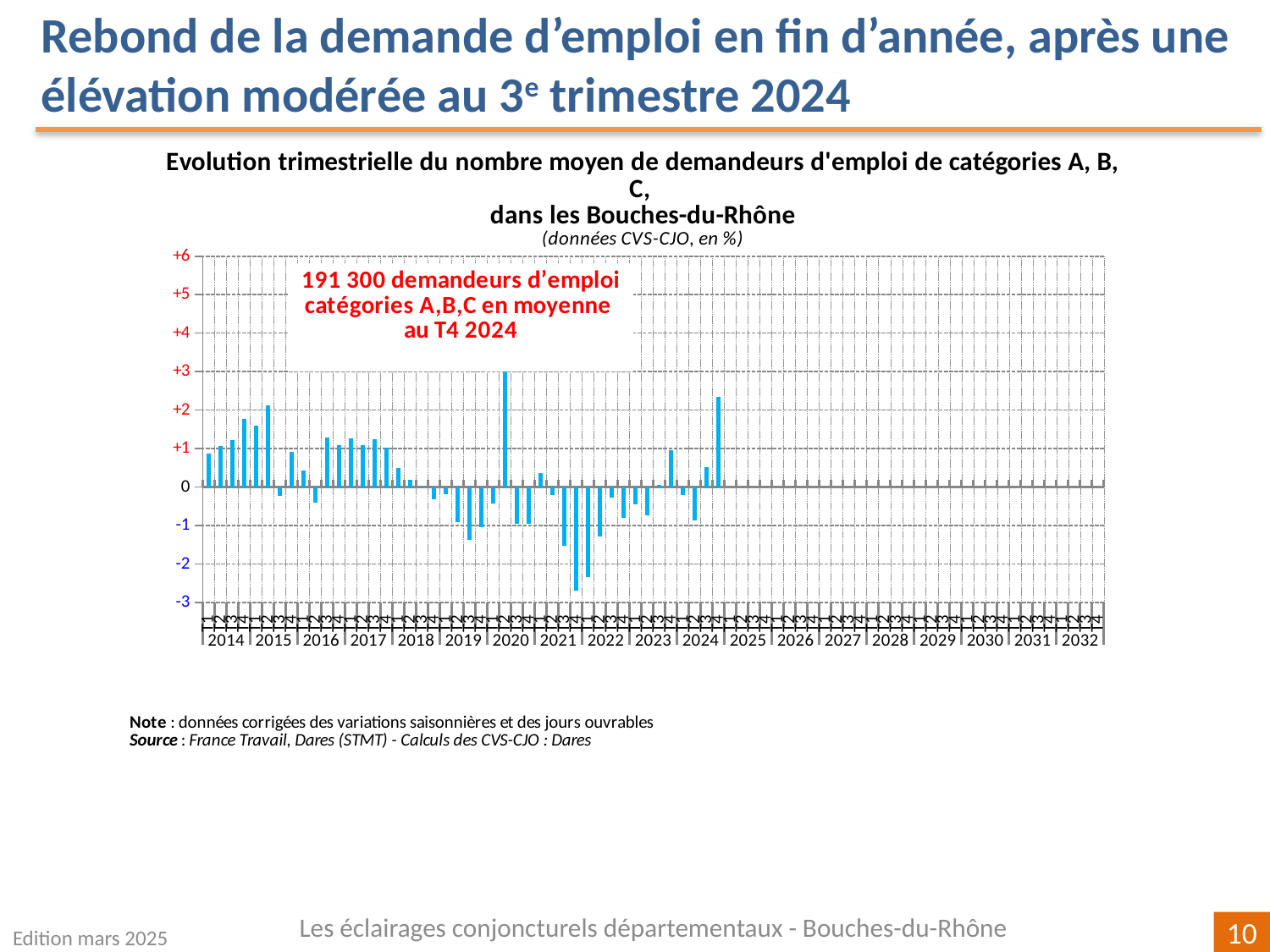
According to the annotation on the chart, how many demandeurs d'emploi catégories A,B,C were there on average in T4 2024? 191 300 Which is larger: the tallest bar in 2020 or the last bar in 2024? the tallest bar in 2020 What is the highest tick value shown on the y axis? +6 Is the value of the tallest bar in 2020 greater or less than +2? greater What kind of chart is shown on the slide? bar chart Are the bars for 2019 mostly positive or negative? negative How many years are labelled on the x axis of the chart? 19 In which year does the lowest (most negative) bar of the chart occur? 2021 Is the value of the last bar in 2024 greater or less than +2? greater In which year does the tallest bar of the chart occur? 2020 Is the value of the lowest bar in 2021 greater or less than -2? less